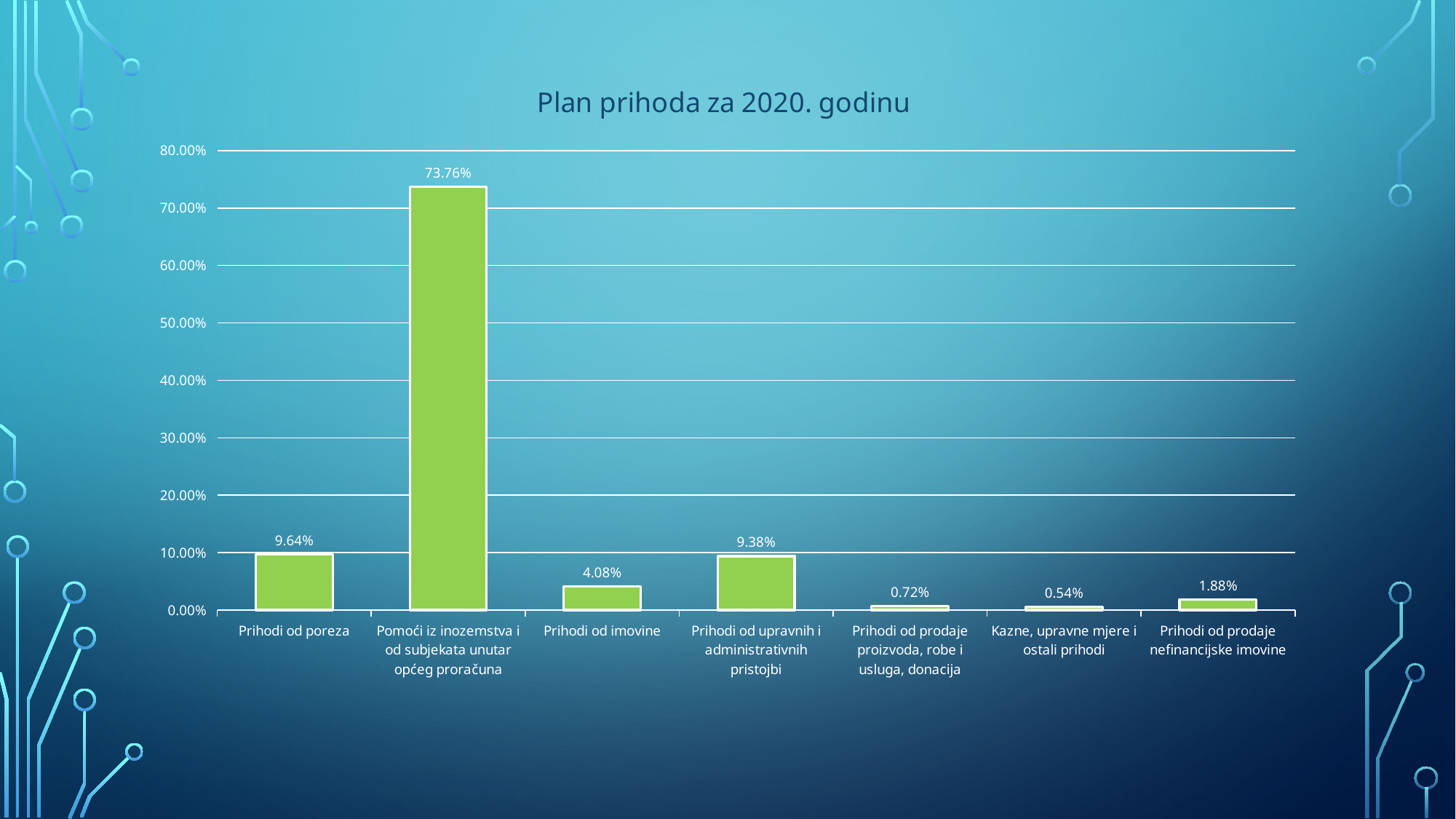
What is the difference between the values for Prihodi od poreza and Prihodi od upravnih i administrativnih pristojbi? 0.26% What is the value for Prihodi od imovine? 4.08% What is the value for Prihodi od prodaje nefinancijske imovine? 1.88% What kind of chart is shown on the slide? bar chart Which is larger, the value for Prihodi od imovine or the value for Prihodi od prodaje nefinancijske imovine? Prihodi od imovine What is the value for Pomoći iz inozemstva i od subjekata unutar općeg proračuna? 73.76% Which category has the lowest value? Kazne, upravne mjere i ostali prihodi How many categories are shown on the x axis? 7 What is the value for Prihodi od poreza? 9.64% What is the title of the chart? Plan prihoda za 2020. godinu Which category has the highest value? Pomoći iz inozemstva i od subjekata unutar općeg proračuna Is the value for Pomoći iz inozemstva i od subjekata unutar općeg proračuna greater or less than 70.00%? greater